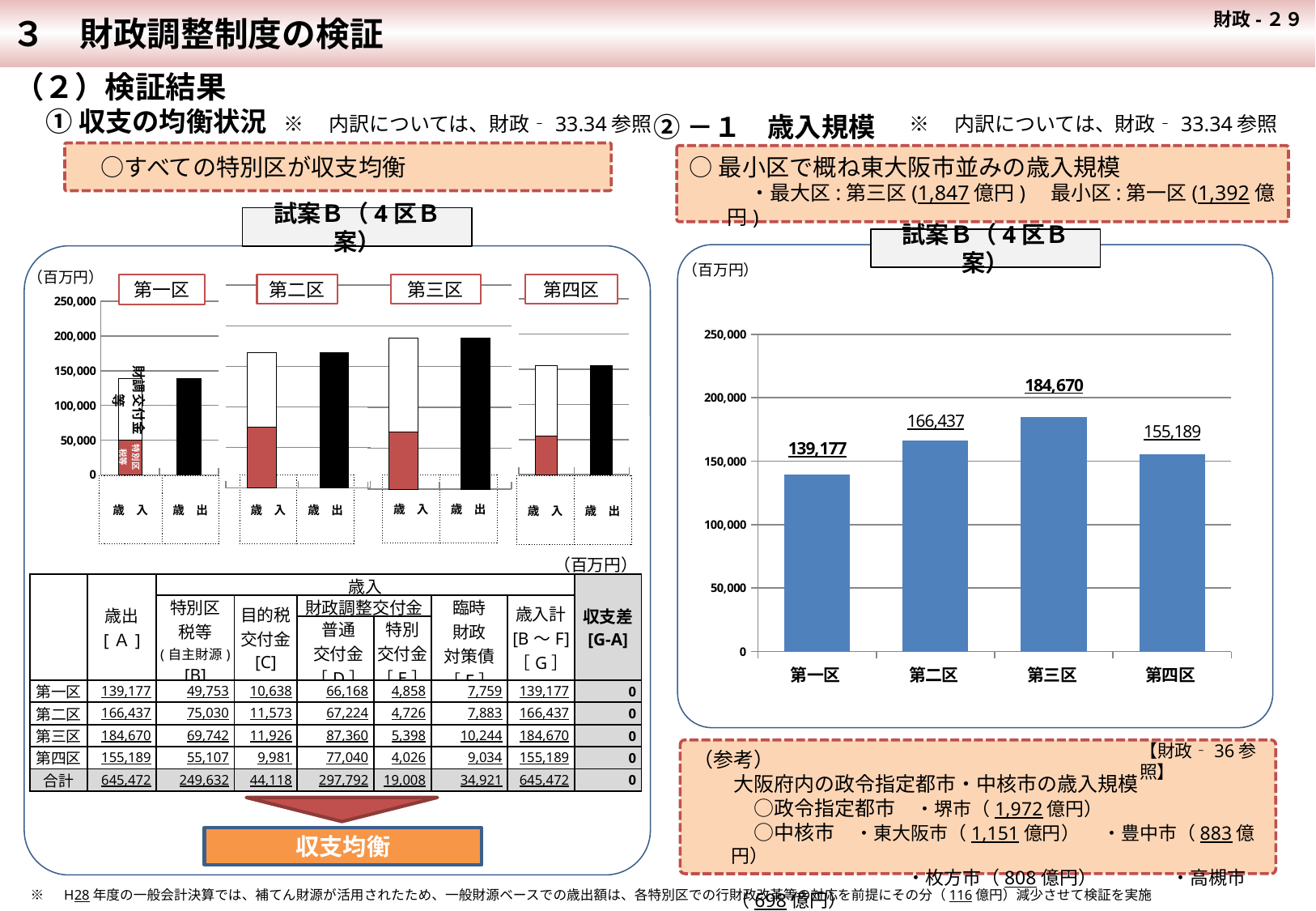
In the right-hand chart (歳入規模), what is the value for 第三区? 184,670 What kind of chart is the right-hand chart (歳入規模)? bar chart In the right-hand chart (歳入規模), which is larger, 第二区 or 第四区? 第二区 In the right-hand chart (歳入規模), what is the difference between 第二区 and 第四区? 11,248 In the left-hand chart (収支の均衡状況), is the 歳出 bar for 第三区 greater or less than 150,000? greater In the right-hand chart (歳入規模), what is the value for 第四区? 155,189 In the right-hand chart (歳入規模), how many districts are plotted? 4 In the right-hand chart (歳入規模), what is the value for 第一区? 139,177 In the left-hand chart (収支の均衡状況), is the 歳出 bar for 第一区 greater or less than 150,000? less In the right-hand chart (歳入規模), what is the difference between 第三区 and 第一区? 45,493 In the right-hand chart (歳入規模), which district has the highest value? 第三区 In the right-hand chart (歳入規模), which district has the lowest value? 第一区